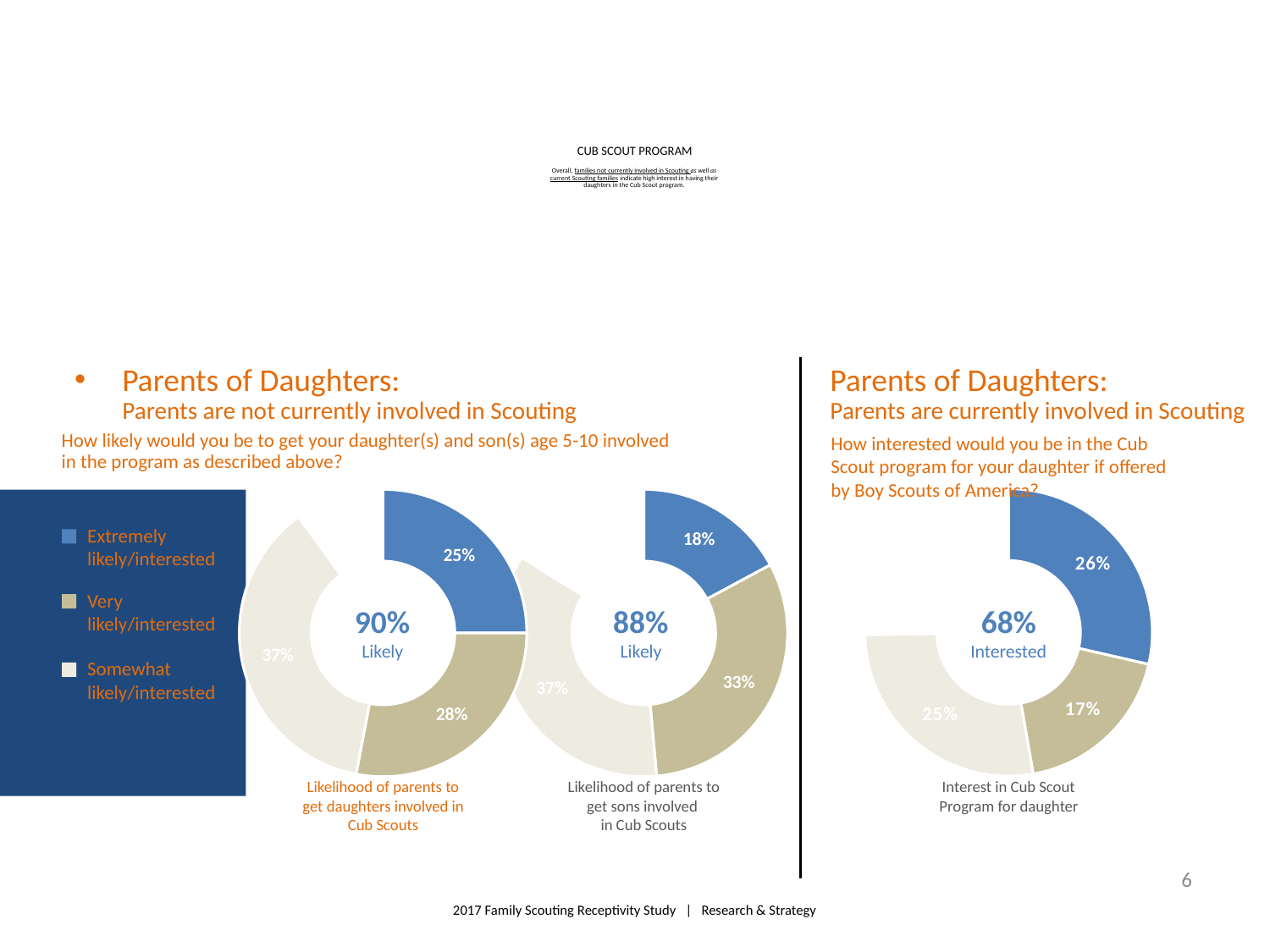
How many donut charts are shown on the slide? 3 In the chart 'Interest in Cub Scout Program for daughter', what percentage are somewhat interested? 25% How many categories does the legend on the slide list? 3 In the chart 'Likelihood of parents to get sons involved in Cub Scouts', what percentage are very likely? 33% What kind of chart is used for 'Likelihood of parents to get daughters involved in Cub Scouts'? Donut (pie) chart What total 'Likely' percentage is shown in the centre of the chart 'Likelihood of parents to get sons involved in Cub Scouts'? 88% In the chart 'Interest in Cub Scout Program for daughter', what is the difference between the extremely interested and very interested shares? 9% In the chart 'Likelihood of parents to get sons involved in Cub Scouts', which category has the smallest share? Extremely likely/interested Which is larger in the chart 'Likelihood of parents to get sons involved in Cub Scouts': the very likely share or the extremely likely share? Very likely/interested What total 'Interested' percentage is shown in the centre of the chart 'Interest in Cub Scout Program for daughter'? 68% In the chart 'Likelihood of parents to get daughters involved in Cub Scouts', what percentage are extremely likely? 25% In the chart 'Likelihood of parents to get daughters involved in Cub Scouts', which category has the largest share? Somewhat likely/interested